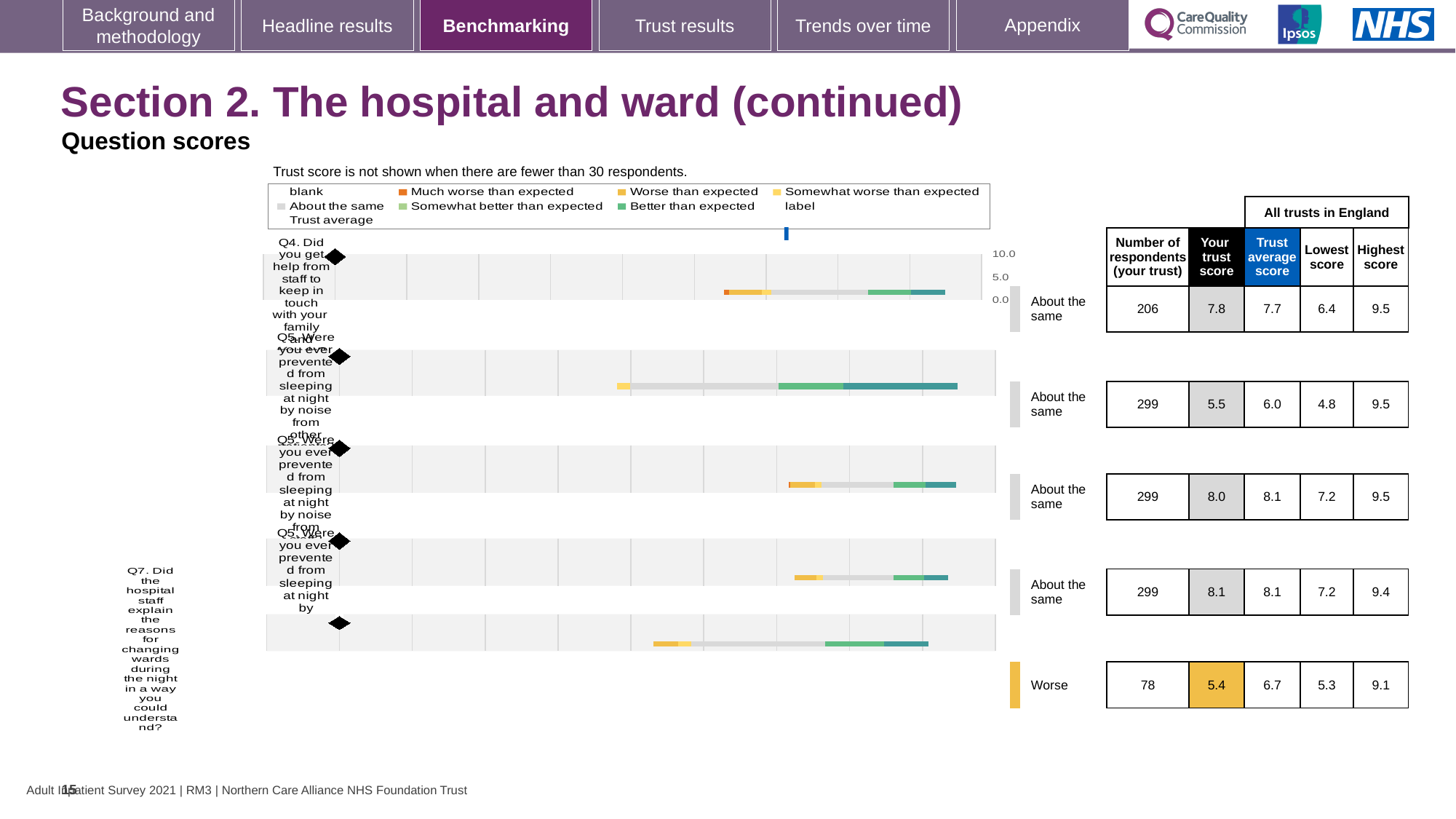
What kind of chart is used to show the question scores on this slide? bar chart What is the difference between the trust average score and your trust score for the last row (78 respondents)? 1.3 What is the 'Highest score' for the last row of the chart (78 respondents)? 9.1 What is the 'Trust average score' for the first row of the chart (206 respondents)? 7.7 What is the 'Your trust score' for the last row of the chart (78 respondents)? 5.4 Which row has the lowest 'Your trust score'? The last row (78 respondents), 5.4 How many rows are rated 'About the same'? 4 For the first row (206 respondents), which is larger: your trust score or the trust average score? Your trust score What rating label is given to the last row of the chart (78 respondents)? Worse What is the highest value shown on the chart's score axis? 10.0 What is the 'Your trust score' for the first row of the chart (206 respondents)? 7.8 How many question rows (bars) are plotted in the chart? 5